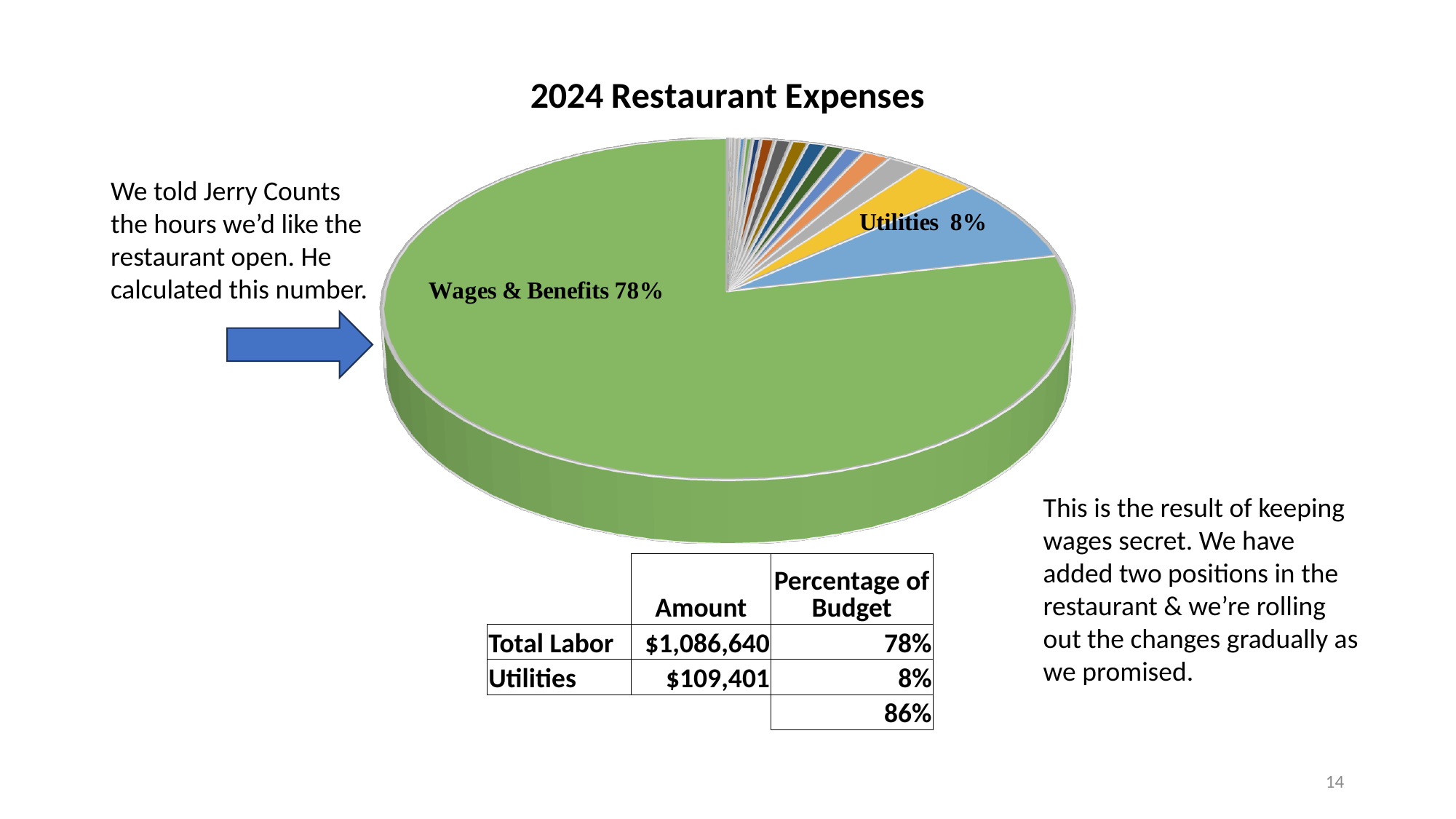
Which labeled slice of the pie is the largest? Wages & Benefits By how many percentage points does the Wages & Benefits share exceed the Utilities share? 70 percentage points What kind of chart is shown on the slide? pie chart What is the combined share of Wages & Benefits and Utilities? 86% Which is larger, the Wages & Benefits slice or the Utilities slice? Wages & Benefits What share of the pie does Utilities represent? 8% What share of the pie does Wages & Benefits represent? 78% What is the title of the chart? 2024 Restaurant Expenses What colour is the Wages & Benefits slice? green Is the share for Wages & Benefits greater or less than 50%? greater